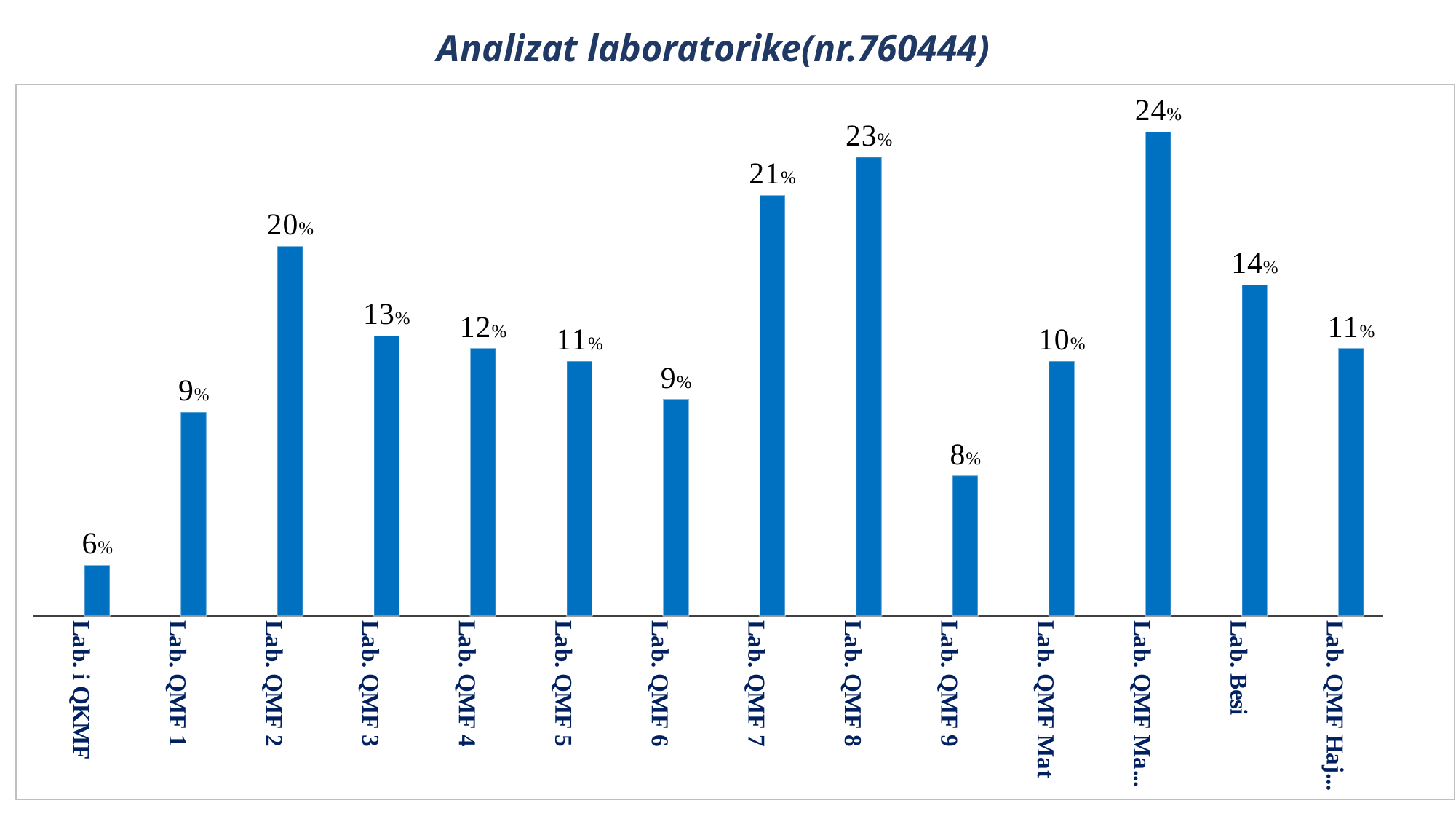
What is the difference between the values for Lab. QMF 7 and Lab. QMF 9? 13% What is the value for Lab. QMF 2? 20% What is the value for Lab. Besi? 14% What is the value for Lab. QMF 8? 23% What is the value for Lab. QMF Mat? 10% How many categories are shown on the chart? 14 What is the highest value shown on the chart? 24% Which category has the lowest value? Lab. i QKMF Which is larger, the value for Lab. QMF 3 or the value for Lab. QMF 5? Lab. QMF 3 What kind of chart is shown on the slide? Bar chart What is the title of the chart? Analizat laboratorike(nr.760444) What is the difference between the values for Lab. QMF 1 and Lab. i QKMF? 3%